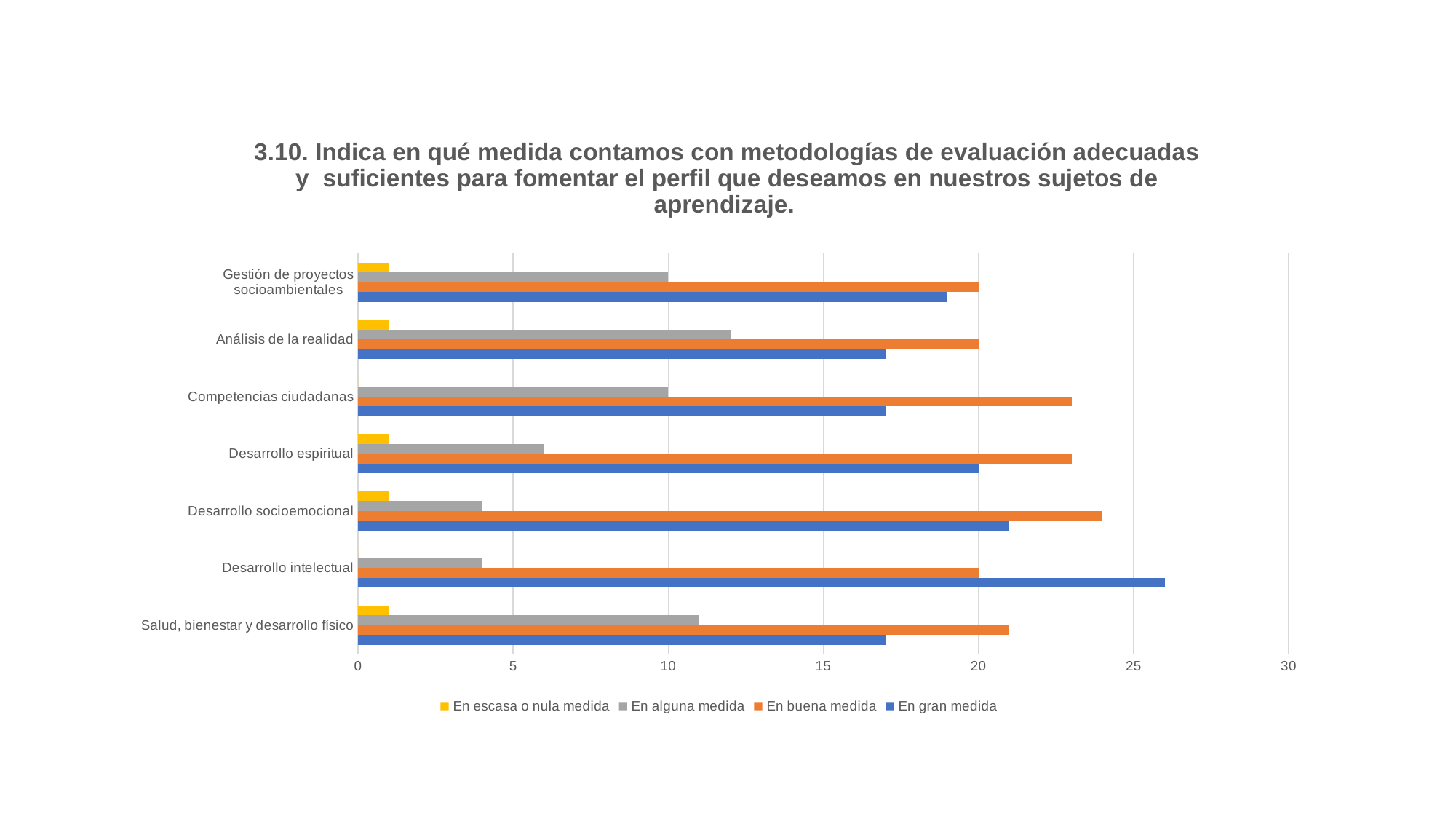
For 'Competencias ciudadanas', which is larger: 'En buena medida' or 'En gran medida'? En buena medida Is the value of 'En gran medida' for 'Desarrollo intelectual' greater or less than 25? greater Which category has the highest value for 'En gran medida'? Desarrollo intelectual Is the value of 'En alguna medida' for 'Desarrollo socioemocional' greater or less than 5? less What is the value of 'En buena medida' for 'Análisis de la realidad'? 20 What colour represents 'En gran medida' in the legend? blue What is the value of 'En gran medida' for 'Desarrollo espiritual'? 20 What kind of chart is shown on the slide? bar chart What is the value of 'En alguna medida' for 'Gestión de proyectos socioambientales'? 10 How many series does the legend list? 4 For 'Desarrollo intelectual', which is larger: 'En gran medida' or 'En buena medida'? En gran medida How many categories are plotted on the chart? 7